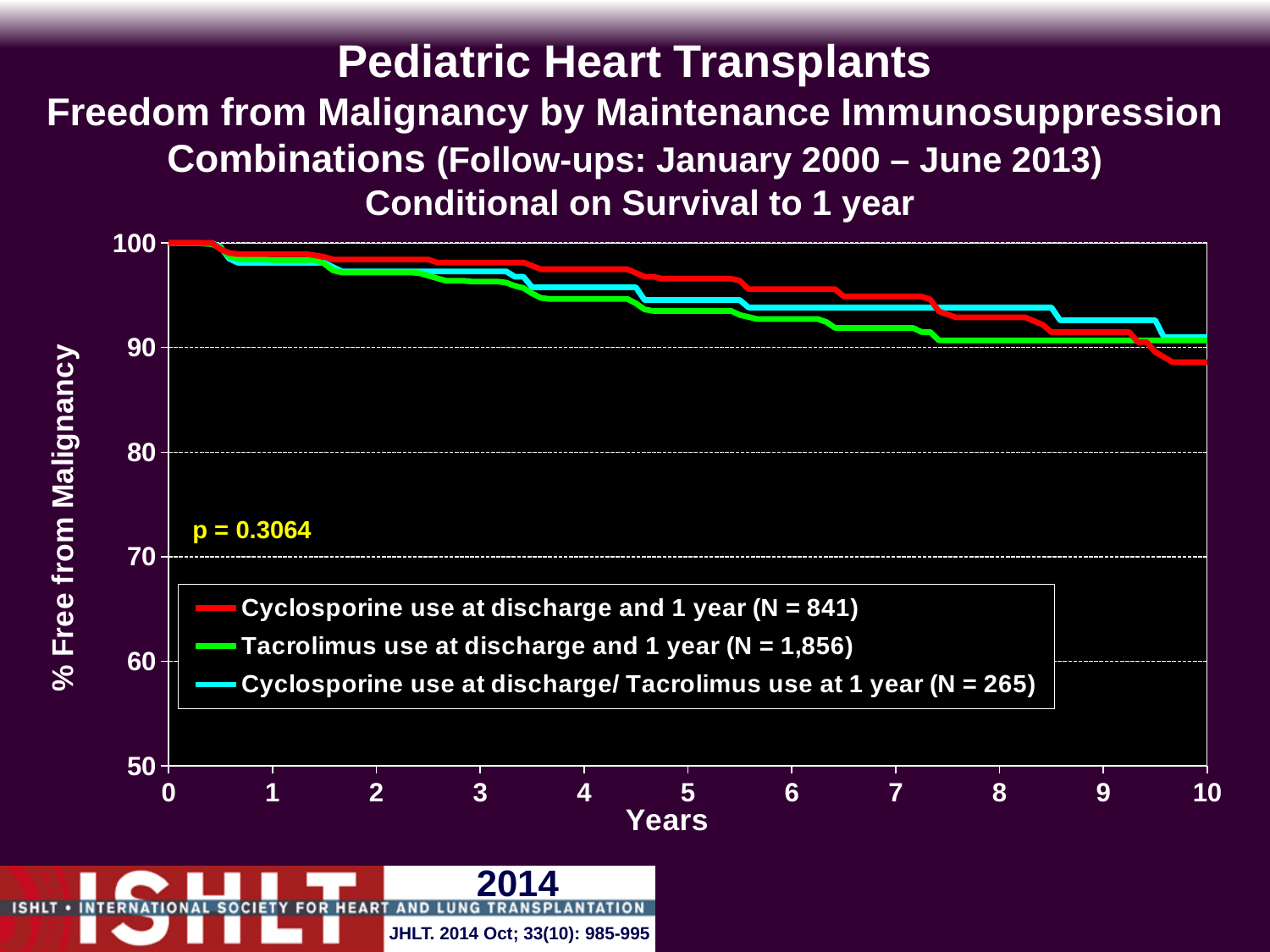
Is the value for Tacrolimus use at discharge and 1 year at 2 years greater or less than 90? greater At 10 years, which is higher: Cyclosporine use at discharge and 1 year or Cyclosporine use at discharge/ Tacrolimus use at 1 year? Cyclosporine use at discharge/ Tacrolimus use at 1 year How many series does the legend list? 3 Is the value for Cyclosporine use at discharge and 1 year at 10 years greater or less than 90? less What is the N for the Tacrolimus use at discharge and 1 year series in the legend? 1,856 Do the values for the Cyclosporine use at discharge and 1 year series rise or fall as years increase? fall What kind of chart is shown on the slide? line chart Is the value for Cyclosporine use at discharge/ Tacrolimus use at 1 year at 5 years greater or less than 90? greater Which series has the lowest value at 10 years? Cyclosporine use at discharge and 1 year Which series has the highest value at 5 years? Cyclosporine use at discharge and 1 year